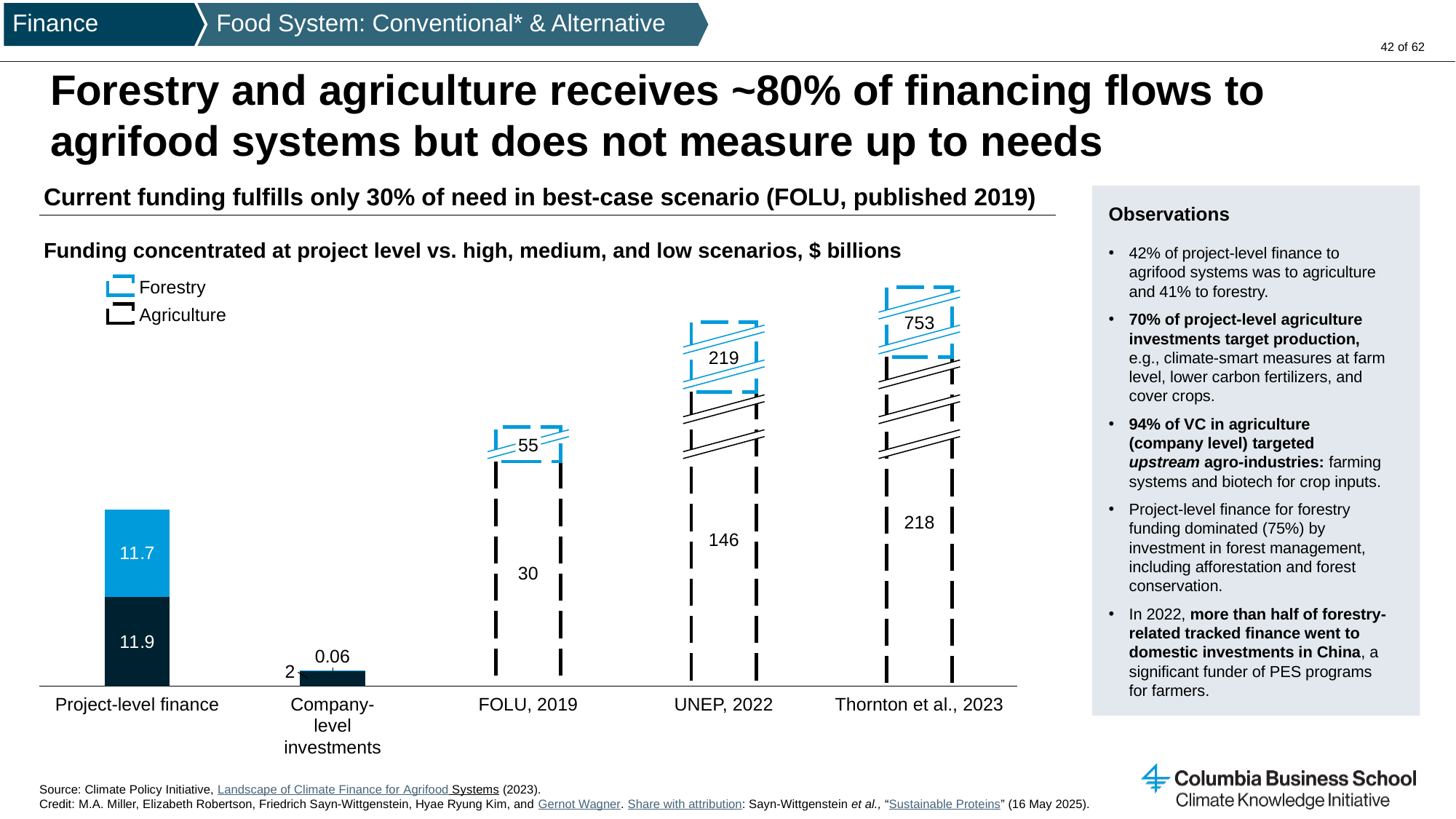
How many categories are shown on the x axis? 5 What is the total of the Project-level finance bar (Forestry plus Agriculture)? 23.6 What is the Agriculture value for FOLU, 2019? 30 How many series does the legend list? 2 Which category has the lowest Agriculture value? Company-level investments What is the difference between the Forestry values for Thornton et al., 2023 and UNEP, 2022? 534 What is the Forestry value for Company-level investments? 0.06 What is the Agriculture value for Project-level finance? 11.9 What is the Forestry value for Project-level finance? 11.7 What is the Agriculture value for Thornton et al., 2023? 218 What is the Forestry value for UNEP, 2022? 219 Which category has the highest Forestry value? Thornton et al., 2023